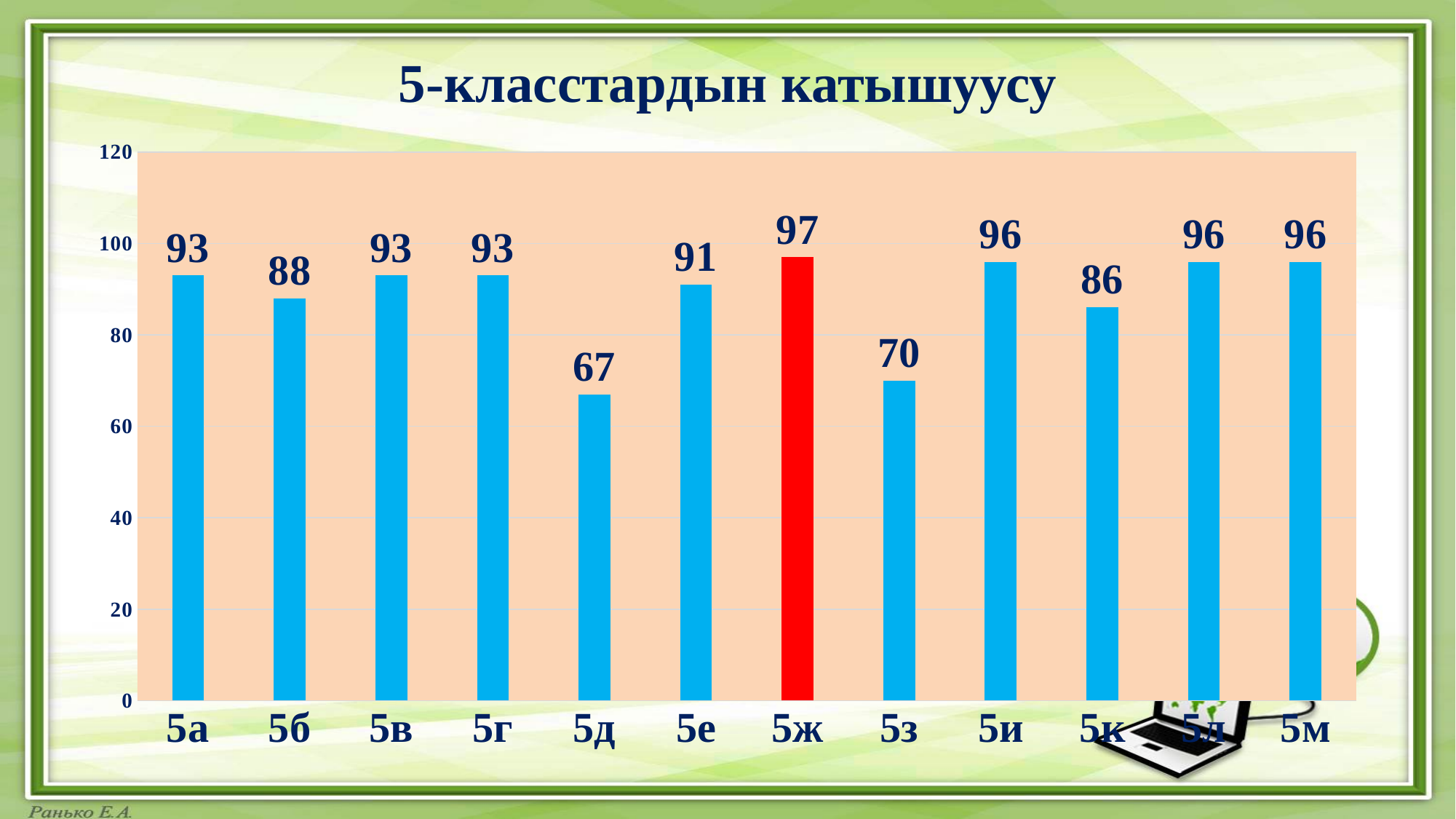
What is the difference between the values for 5ж and 5д? 30 What is the value for 5ж? 97 Which bar is coloured red instead of blue? 5ж What kind of chart is this? bar chart What is the value for 5д? 67 Is the value for 5е greater or less than 80? greater Which category has the lowest value? 5д How many categories are shown on the x axis? 12 What is the value for 5к? 86 Which category has the highest value? 5ж What is the difference between the values for 5а and 5б? 5 Which is larger, the value for 5з or the value for 5к? 5к